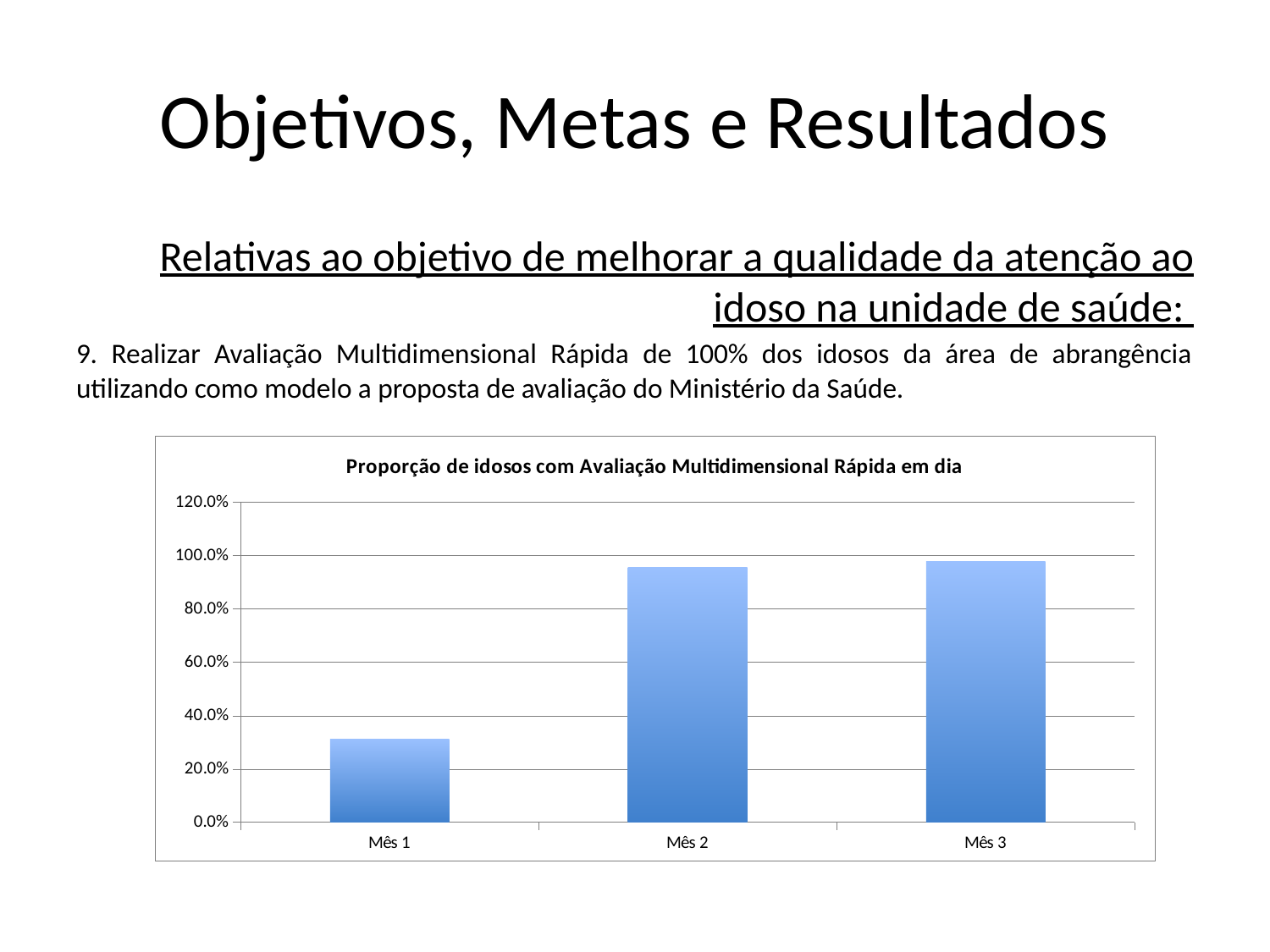
Is the value for Mês 1 greater or less than 40.0%? less Is the value for Mês 1 greater or less than 20.0%? greater Is the value for Mês 3 greater or less than 80.0%? greater Do the values rise or fall from Mês 1 to Mês 3? rise Which is larger, the value for Mês 1 or the value for Mês 2? Mês 2 Which is larger, the value for Mês 1 or the value for Mês 3? Mês 3 What kind of chart is shown on the slide? bar chart What is the title of the chart? Proporção de idosos com Avaliação Multidimensional Rápida em dia Which category has the lowest value in the chart? Mês 1 How many categories are plotted on the x axis of the chart? 3